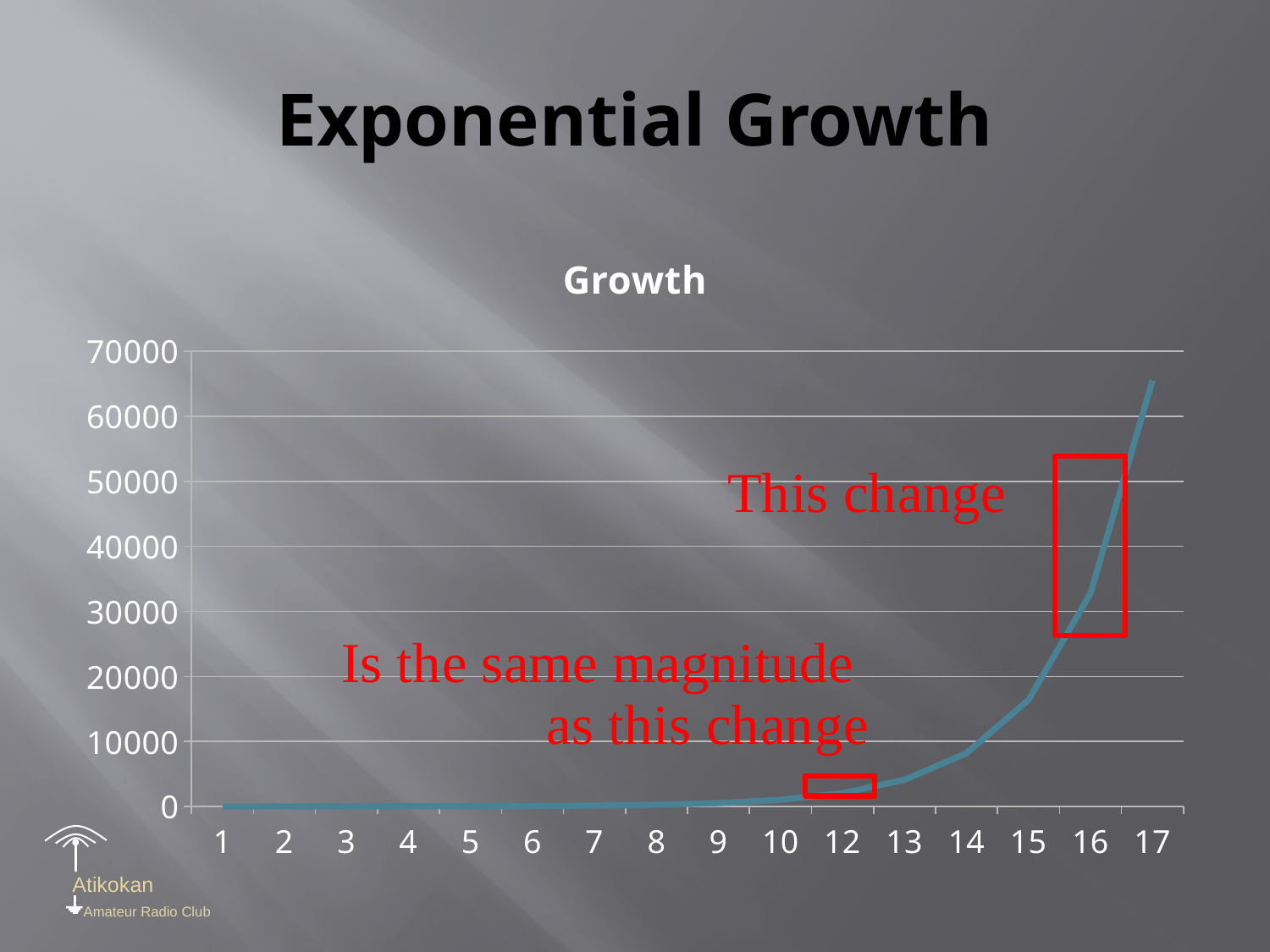
Is the value at x = 17 greater or less than 60000? greater Is the value at x = 16 greater or less than 40000? less How many category labels are shown on the x axis? 16 What is the title of the chart? Growth Which has the larger value, x = 16 or x = 17? 17 What kind of chart is shown on the slide? line chart What is the highest value shown on the y axis? 70000 Is the value at x = 14 greater or less than 10000? less Do the values rise or fall as the x axis goes from 1 to 17? rise Which x-axis category has the highest value? 17